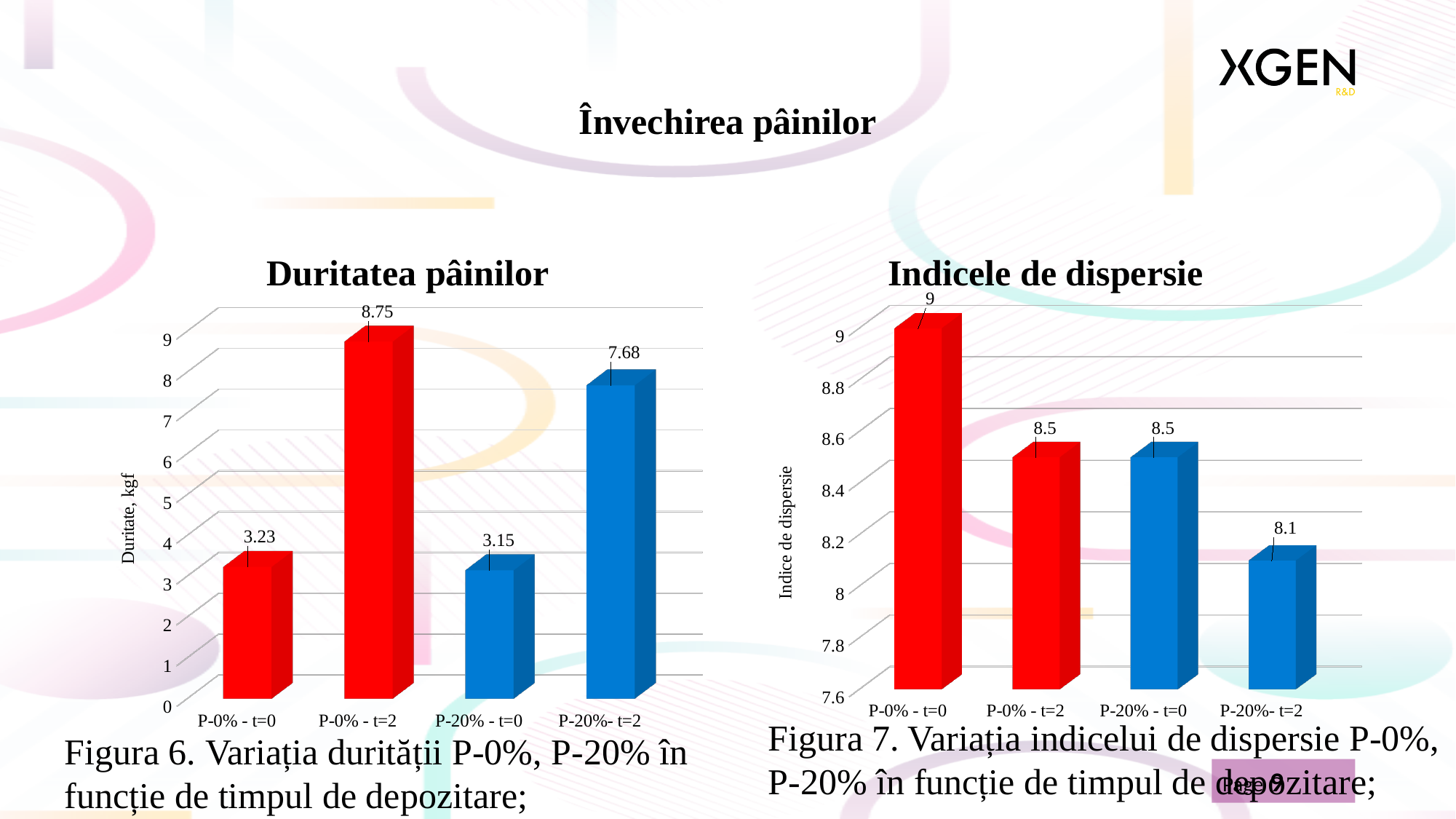
In the 'Duritatea pâinilor' chart, which category has the highest value? P-0% - t=2 In the 'Duritatea pâinilor' chart, how many bars are plotted? 4 What is the y-axis label of the 'Duritatea pâinilor' chart? Duritate, kgf In the 'Indicele de dispersie' chart, what is the value for P-0% - t=0? 9 In the 'Duritatea pâinilor' chart, what is the value for P-20% - t=0? 3.15 In the 'Indicele de dispersie' chart, which category has the lowest value? P-20%- t=2 In the 'Indicele de dispersie' chart, what is the value for P-20%- t=2? 8.1 In the 'Duritatea pâinilor' chart, what is the difference between the values for P-0% - t=2 and P-20%- t=2? 1.07 In the 'Duritatea pâinilor' chart, what is the value for P-0% - t=2? 8.75 In the 'Duritatea pâinilor' chart, which is larger: the value for P-0% - t=0 or P-20% - t=0? P-0% - t=0 What kind of chart is 'Duritatea pâinilor'? Bar chart In the 'Indicele de dispersie' chart, what is the difference between the values for P-0% - t=0 and P-0% - t=2? 0.5